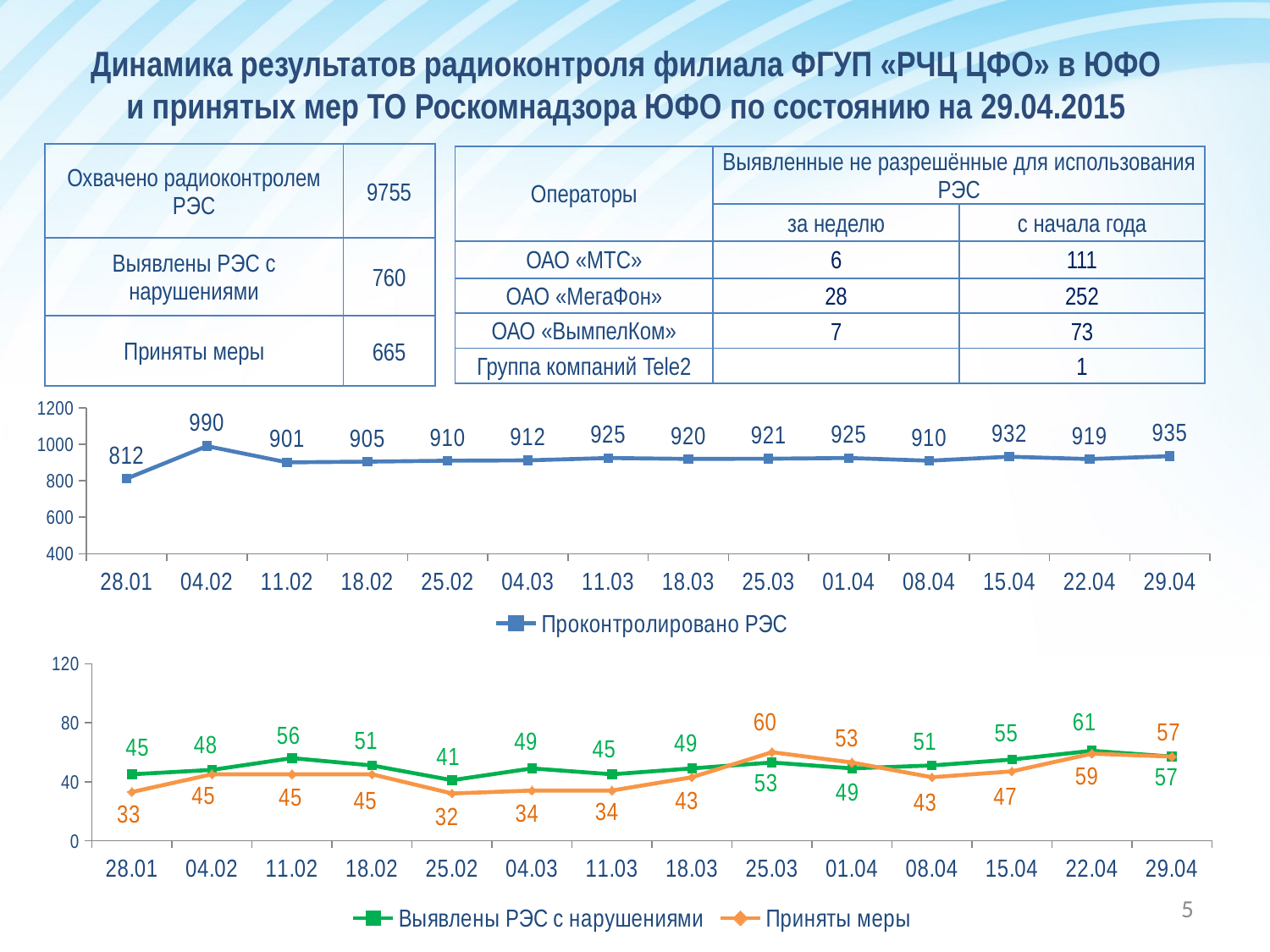
In the top chart, on which date is Проконтролировано РЭС highest? 04.02 In the bottom chart, what is the value of Приняты меры on 25.03? 60 In the top chart, on which date is Проконтролировано РЭС lowest? 28.01 In the bottom chart, what is the value of Выявлены РЭС с нарушениями on 22.04? 61 What type of chart is the top chart? Line chart In the bottom chart, what is the difference between Выявлены РЭС с нарушениями and Приняты меры on 28.01? 12 In the top chart, what is the value of Проконтролировано РЭС on 04.02? 990 In the bottom chart, on which date is Приняты меры lowest? 25.02 How many series does the legend of the bottom chart list? 2 How many data points does the top chart (Проконтролировано РЭС) show? 14 In the bottom chart, which is larger on 25.03: Выявлены РЭС с нарушениями or Приняты меры? Приняты меры In the top chart, what is the difference between the values on 29.04 and 28.01? 123